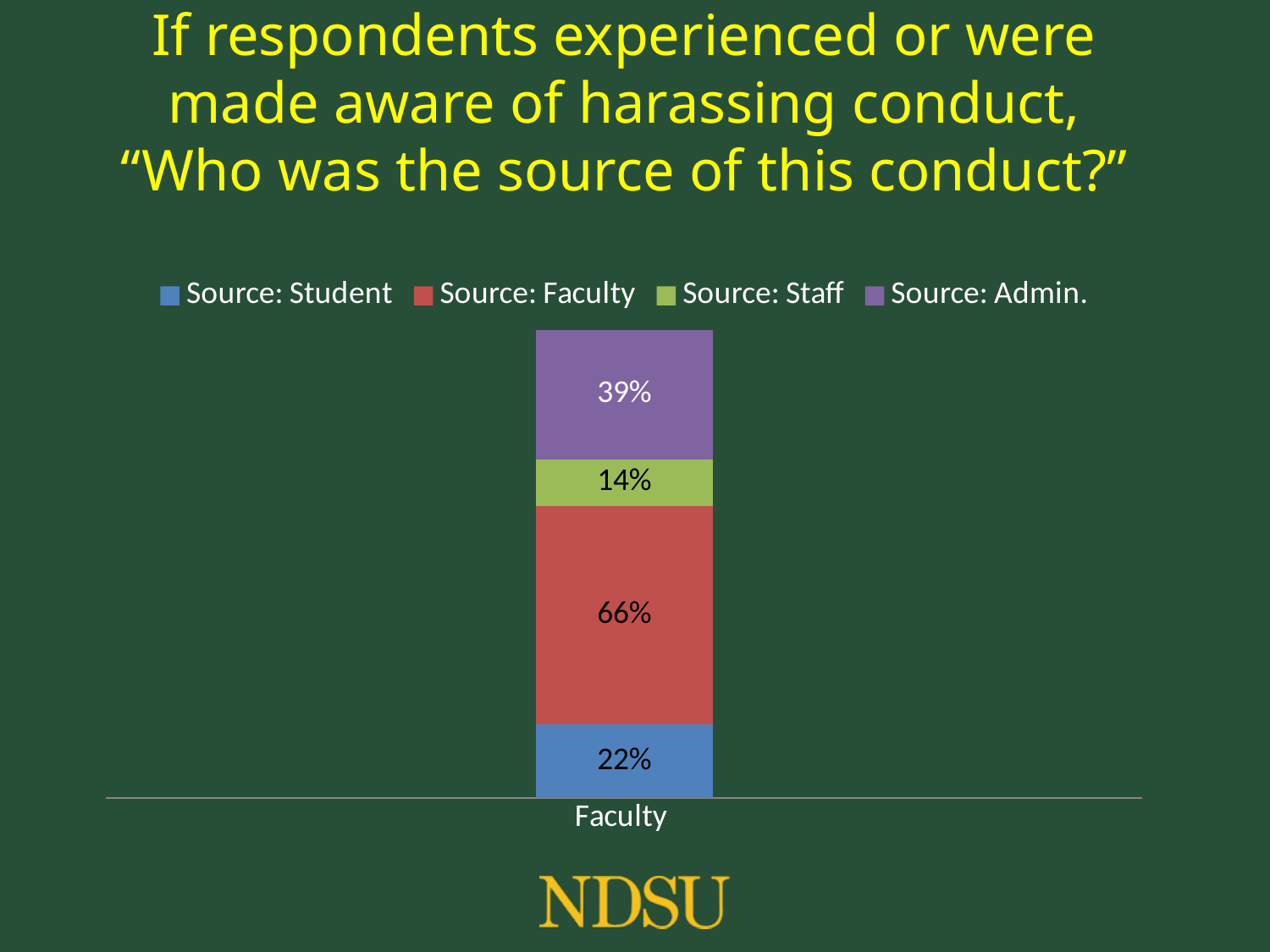
Which source has the highest value in the Faculty bar? Source: Faculty What is the difference between the Source: Student value and the Source: Staff value? 8% What is the difference between the Source: Faculty value and the Source: Admin. value? 27% What percentage of faculty respondents identified a student as the source of the harassing conduct? 22% What is the category label shown on the x axis? Faculty Which source has the lowest value in the Faculty bar? Source: Staff What is the value for Source: Staff in the Faculty bar? 14% What kind of chart is shown on the slide? Stacked bar chart What is the value for Source: Faculty in the Faculty bar? 66% How many series does the legend list? 4 Which is larger, the value for Source: Admin. or the value for Source: Student? Source: Admin. What is the value for Source: Admin. in the Faculty bar? 39%